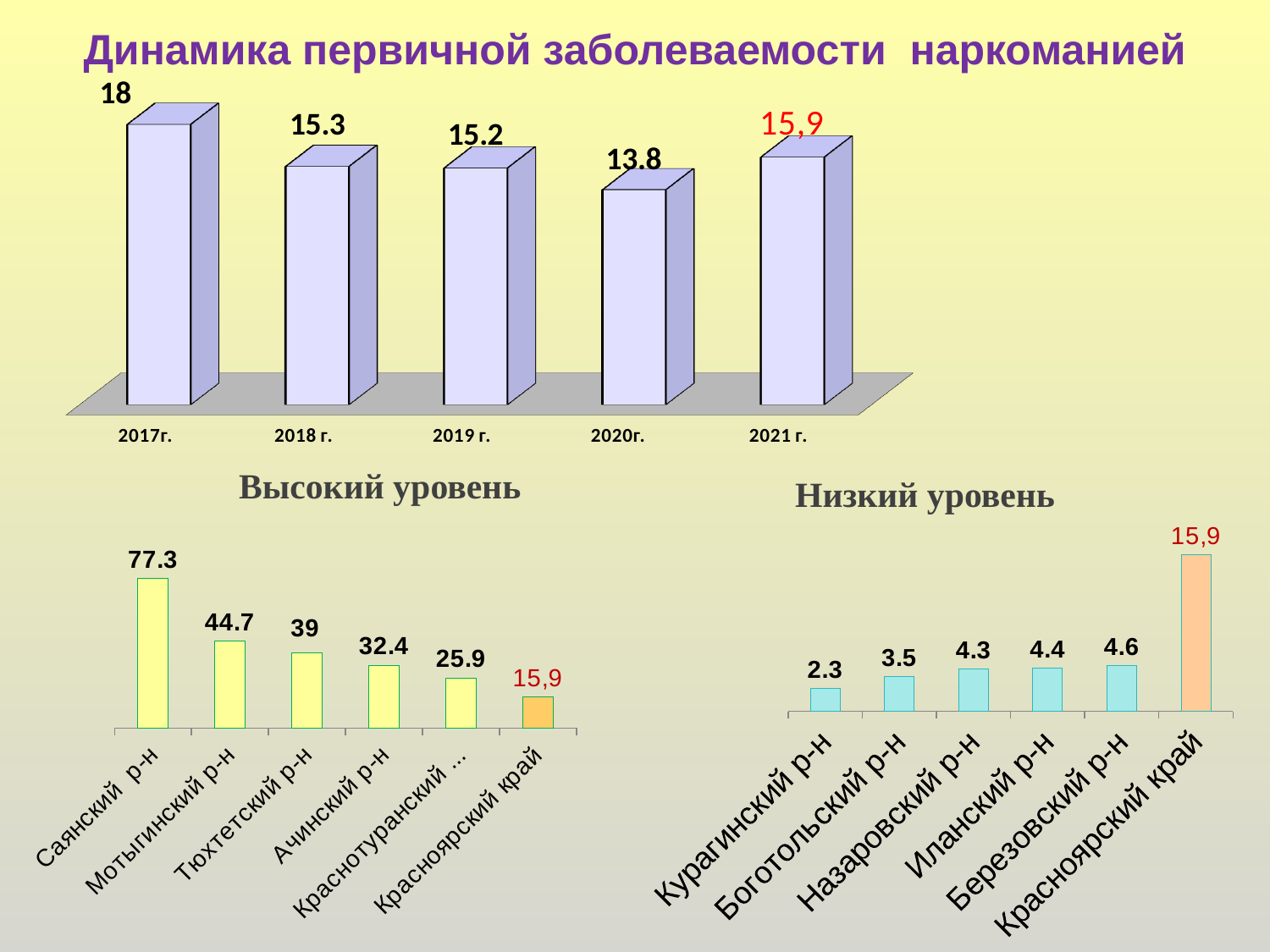
In the chart titled Высокий уровень, do the values rise or fall from left to right? fall In the chart titled Низкий уровень, what is the value for Курагинский р-н? 2.3 In the top chart (Динамика первичной заболеваемости наркоманией), which year has the lowest value? 2020г. In the top chart (Динамика первичной заболеваемости наркоманией), what is the value for 2017г.? 18 In the top chart (Динамика первичной заболеваемости наркоманией), what is the difference between the values for 2017г. and 2018 г.? 2.7 In the top chart (Динамика первичной заболеваемости наркоманией), what kind of chart is it? bar chart In the top chart (Динамика первичной заболеваемости наркоманией), what is the value for 2020г.? 13.8 In the top chart (Динамика первичной заболеваемости наркоманией), how many years are shown? 5 In the chart titled Высокий уровень, which category has the highest value? Саянский р-н In the chart titled Низкий уровень, which is larger, the value for Боготольский р-н or the value for Березовский р-н? Березовский р-н In the chart titled Низкий уровень, how many categories are shown? 6 In the chart titled Высокий уровень, what is the value for Мотыгинский р-н? 44.7